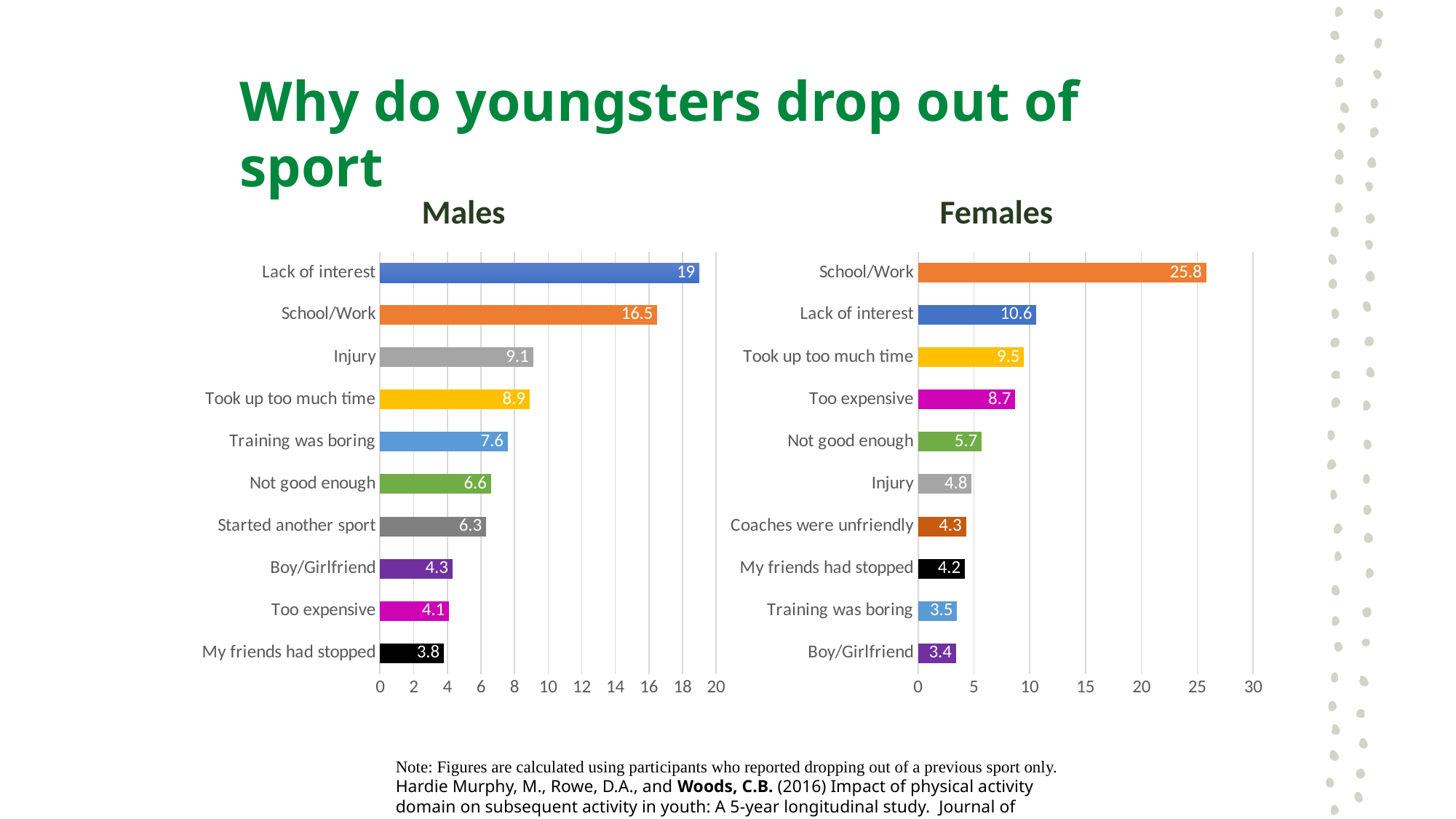
In the Females chart, which category has the highest value? School/Work In the Males chart, what is the difference between Lack of interest and School/Work? 2.5 In the Females chart, what is the value for School/Work? 25.8 In the Males chart, what is the value for Injury? 9.1 In the Females chart, what is the value for Coaches were unfriendly? 4.3 How many categories are shown in the Males chart? 10 In the Males chart, what is the value for Lack of interest? 19 In the Females chart, what is the difference between School/Work and Lack of interest? 15.2 In the Males chart, which category has the lowest value? My friends had stopped In the Females chart, is the value for Took up too much time greater or less than 10? less What kind of chart is the Females chart? Bar chart Which is larger: Too expensive in the Males chart or Too expensive in the Females chart? Females